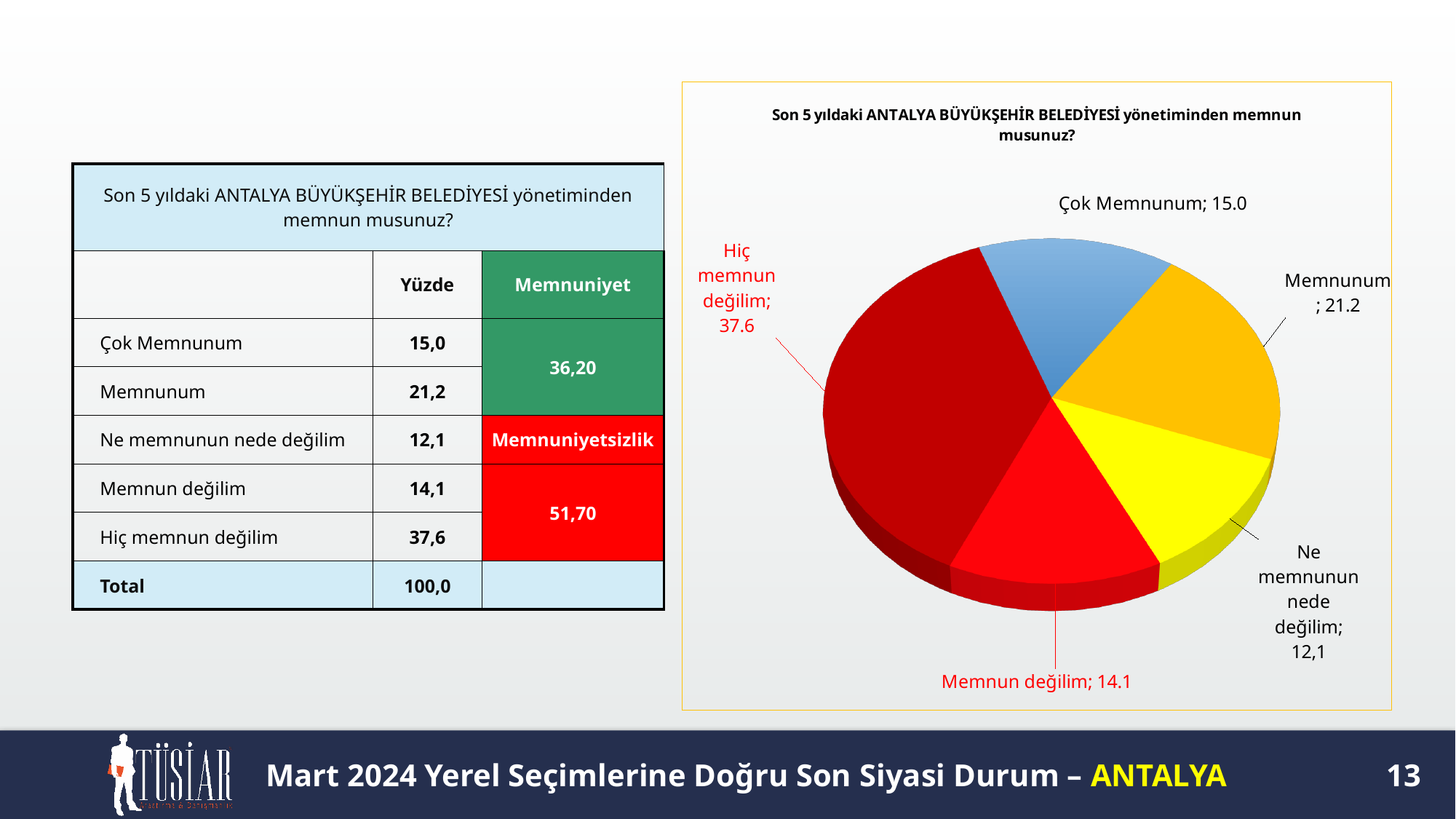
What value does the pie chart show for Memnunum? 21.2 How many slices does the pie chart have? 5 What is the title of the pie chart? Son 5 yıldaki ANTALYA BÜYÜKŞEHİR BELEDİYESİ yönetiminden memnun musunuz? What value does the pie chart show for Hiç memnun değilim? 37.6 Which slice of the pie chart is the largest? Hiç memnun değilim What value does the pie chart show for Çok Memnunum? 15.0 What value does the pie chart show for Memnun değilim? 14.1 What colour is the Çok Memnunum slice in the pie chart? Blue Which is larger in the pie chart, Memnunum or Memnun değilim? Memnunum What is the difference between the values for Hiç memnun değilim and Memnunum in the pie chart? 16.4 Which slice of the pie chart is the smallest? Ne memnunun nede değilim What kind of chart is shown on the slide? Pie chart